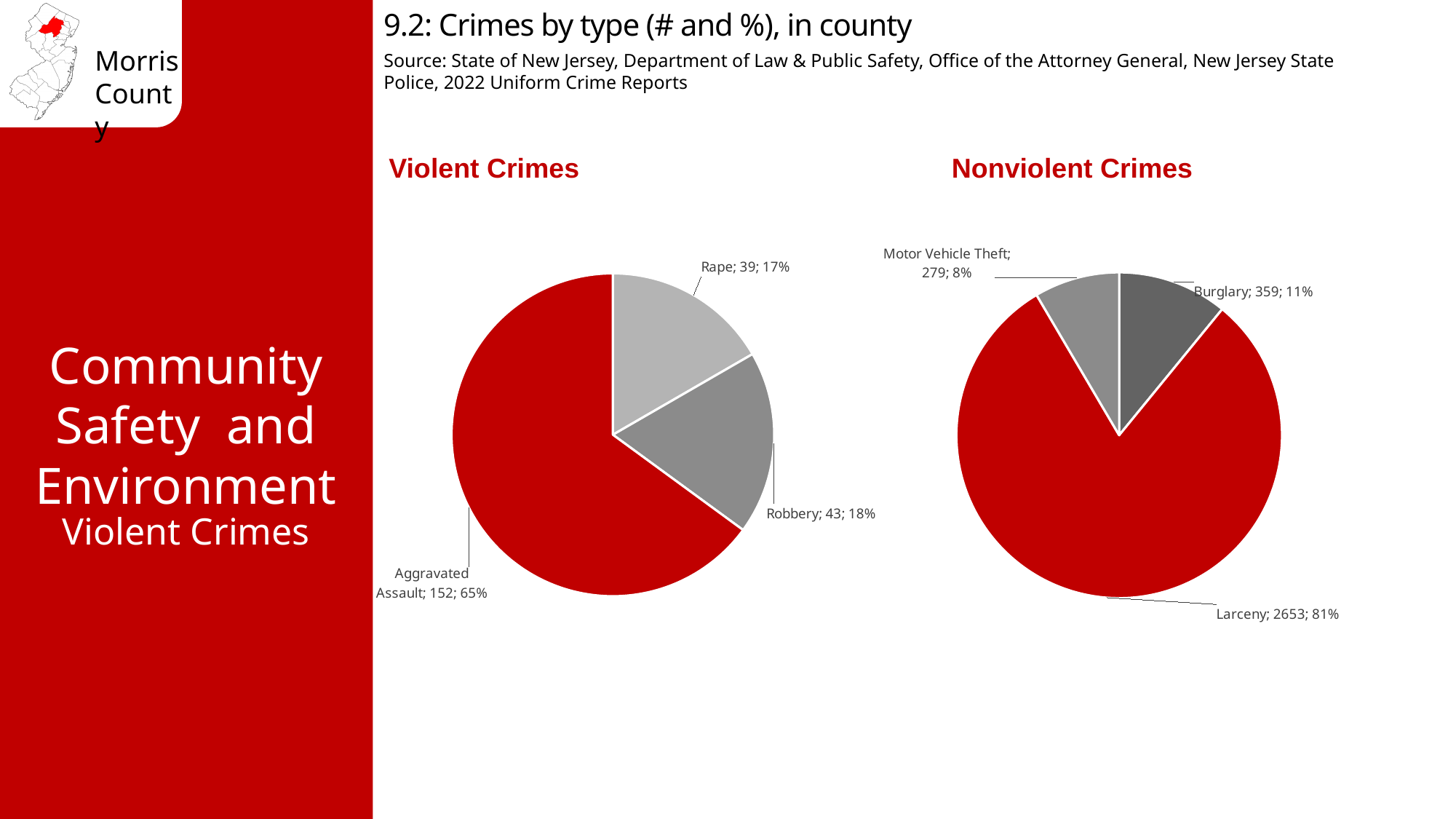
In the Nonviolent Crimes chart, how many larcenies are shown? 2653 In the Violent Crimes chart, which category has the largest slice? Aggravated Assault What type of chart is used for the Violent Crimes chart? Pie chart In the Nonviolent Crimes chart, what is the difference between the Burglary count and the Motor Vehicle Theft count? 80 In the Nonviolent Crimes chart, which is larger, Burglary or Motor Vehicle Theft? Burglary In the Nonviolent Crimes chart, which category has the smallest slice? Motor Vehicle Theft In the Nonviolent Crimes chart, what percentage share does Motor Vehicle Theft have? 8% In the Violent Crimes chart, how many aggravated assaults are shown? 152 In the Violent Crimes chart, how many categories are shown? 3 In the Violent Crimes chart, which category has the smallest slice? Rape In the Violent Crimes chart, what percentage share does Rape have? 17% In the Violent Crimes chart, what is the difference between the Robbery count and the Rape count? 4